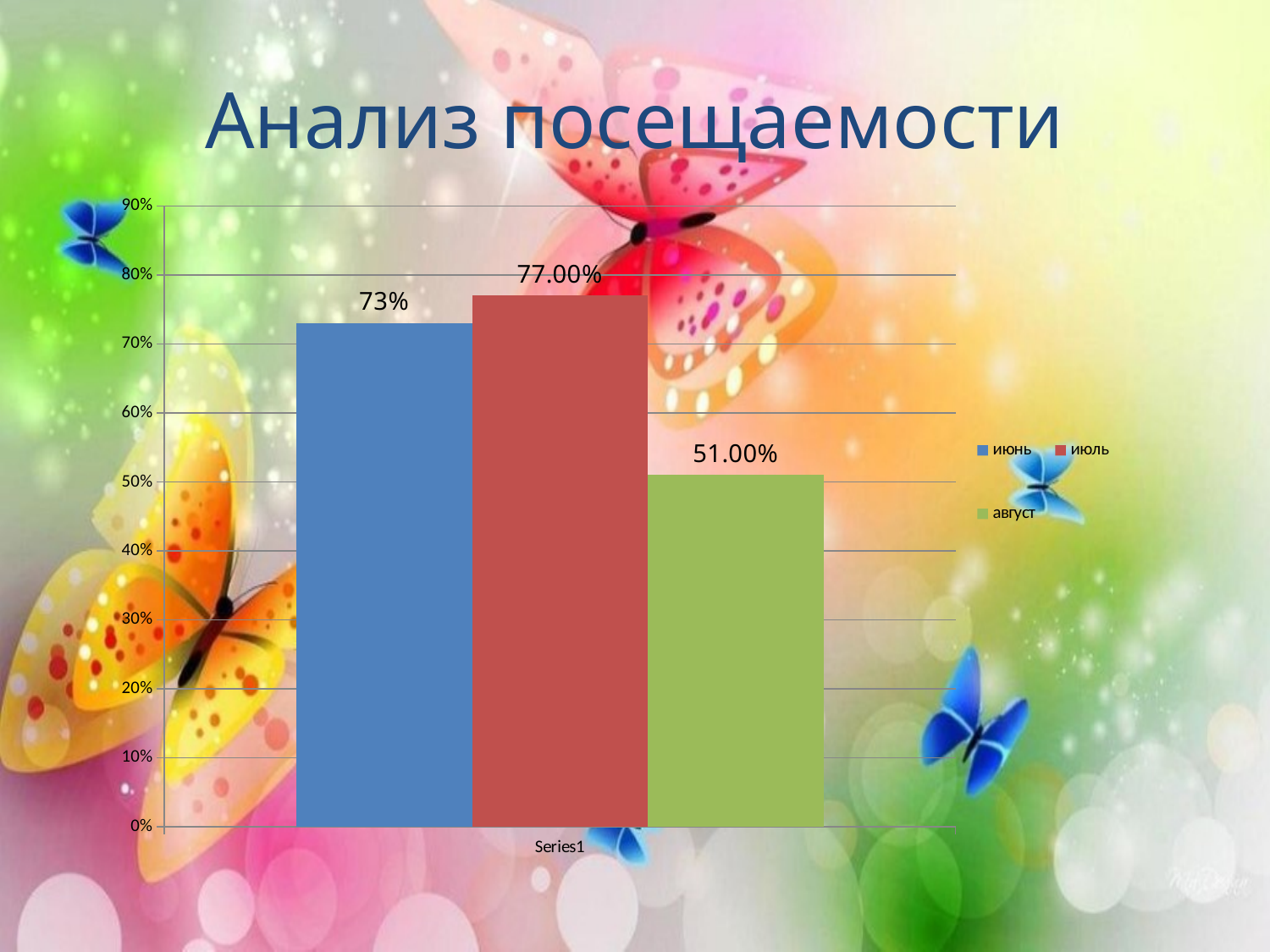
Which month has the highest value? июль What kind of chart is shown on the slide? bar chart Which month has the lowest value? август What is the value shown for август? 51.00% How many series does the legend list? 3 What is the title of the slide? Анализ посещаемости What is the value shown for июль? 77.00% What is the difference between the values for июнь and август? 22 percentage points Which is larger, the value for июнь or the value for август? июнь Is the value for август greater or less than 60%? less What is the value shown for июнь? 73% What is the difference between the values for июль and июнь? 4 percentage points